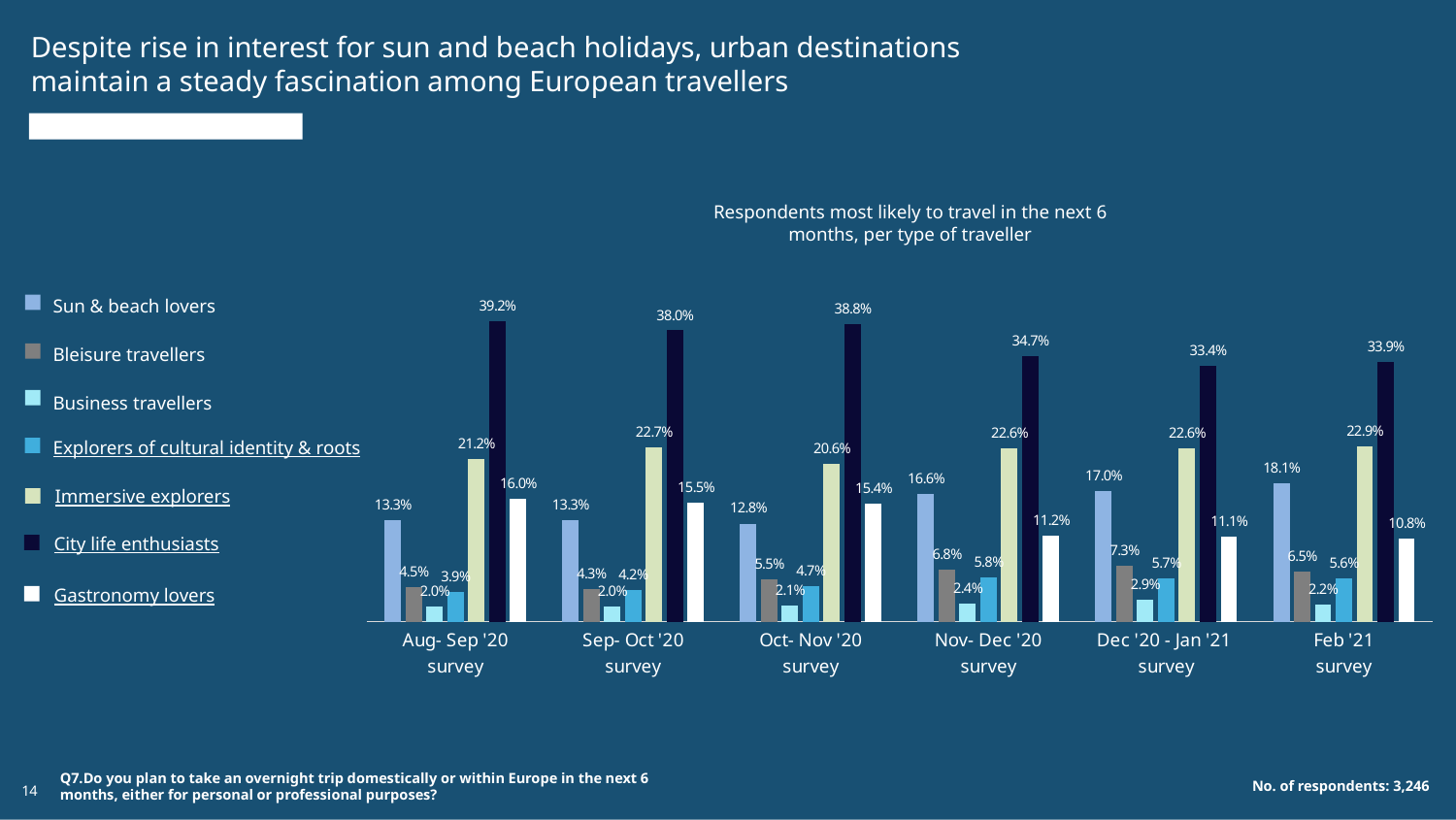
What kind of chart is shown on the slide? Bar chart In which survey did Gastronomy lovers record their lowest value? Feb '21 survey In the Nov-Dec '20 survey, which is larger: Immersive explorers or Gastronomy lovers? Immersive explorers What is the value for Bleisure travellers in the Dec '20 - Jan '21 survey? 7.3% Do the values for Gastronomy lovers rise or fall from the Aug-Sep '20 survey to the Feb '21 survey? Fall In which survey did City life enthusiasts record their highest value? Aug-Sep '20 survey What is the title of the chart? Respondents most likely to travel in the next 6 months, per type of traveller What percentage of City life enthusiasts were most likely to travel in the next 6 months in the Aug-Sep '20 survey? 39.2% How many traveller types does the legend list? 7 How many survey periods are shown on the x axis? 6 What is the value for Sun & beach lovers in the Feb '21 survey? 18.1% By how many percentage points did the value for City life enthusiasts fall from the Aug-Sep '20 survey to the Feb '21 survey? 5.3 percentage points